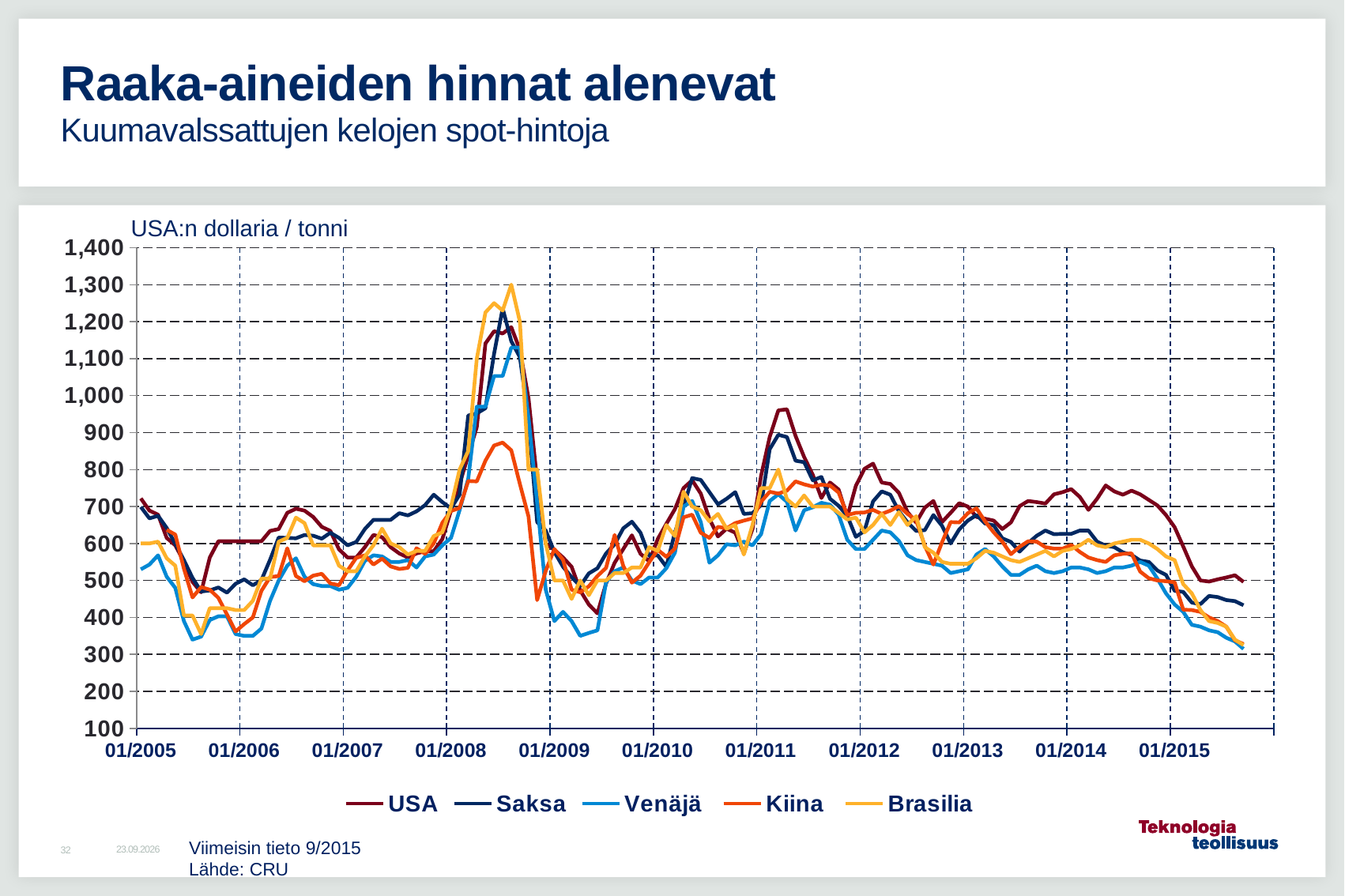
Which series reaches the highest peak in 2008? Brasilia At the end of the series, is the value for USA higher or lower than the value for Venäjä? higher Is the value for USA at 01/2009 greater or less than 700? less What kind of chart is shown on the slide? line chart Which series has the lowest peak in 2008? Kiina What unit is given for the y axis of the chart? USA:n dollaria / tonni Do the values for Venäjä rise or fall from 01/2014 to the end of the series? fall How many series does the legend list? 5 Is the peak value for Brasilia in 2008 greater or less than 1,200? greater Is the peak value for Kiina in 2008 greater or less than 900? less Do the values for USA rise or fall from 01/2005 to 01/2006? fall What is the subtitle of the slide describing the chart? Kuumavalssattujen kelojen spot-hintoja